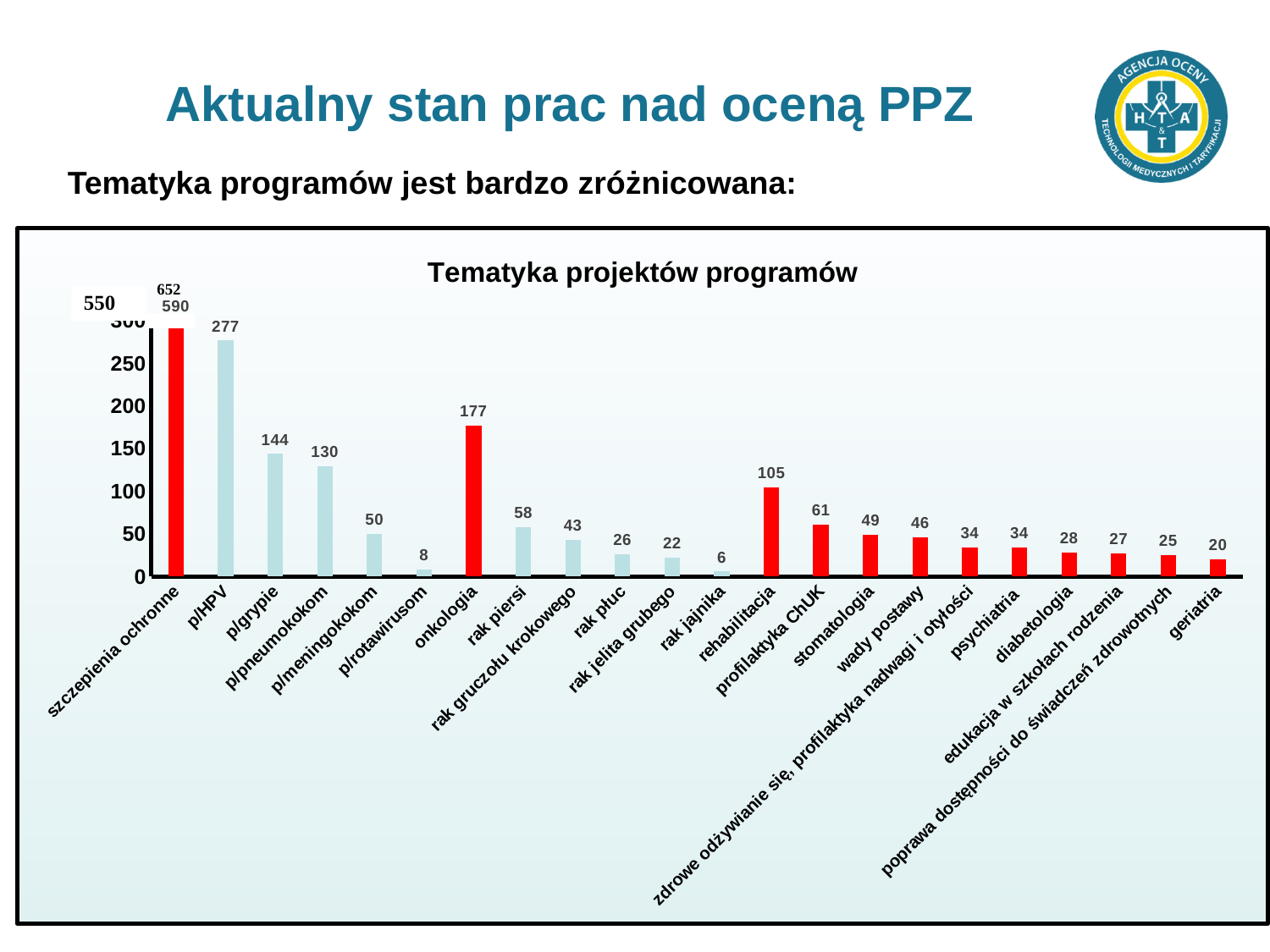
What is the difference between the values for p/grypie and p/pneumokokom? 14 What is the title of the chart? Tematyka projektów programów Which category has the highest value? szczepienia ochronne Which category has the lowest value? rak jajnika What is the value for rehabilitacja? 105 What is the value for geriatria? 20 What is the difference between the values for stomatologia and wady postawy? 3 How many categories are shown on the x axis? 22 What is the value for onkologia? 177 What is the value for p/HPV? 277 Which is larger, the value for rak piersi or the value for profilaktyka ChUK? profilaktyka ChUK What type of chart is shown on the slide? bar chart